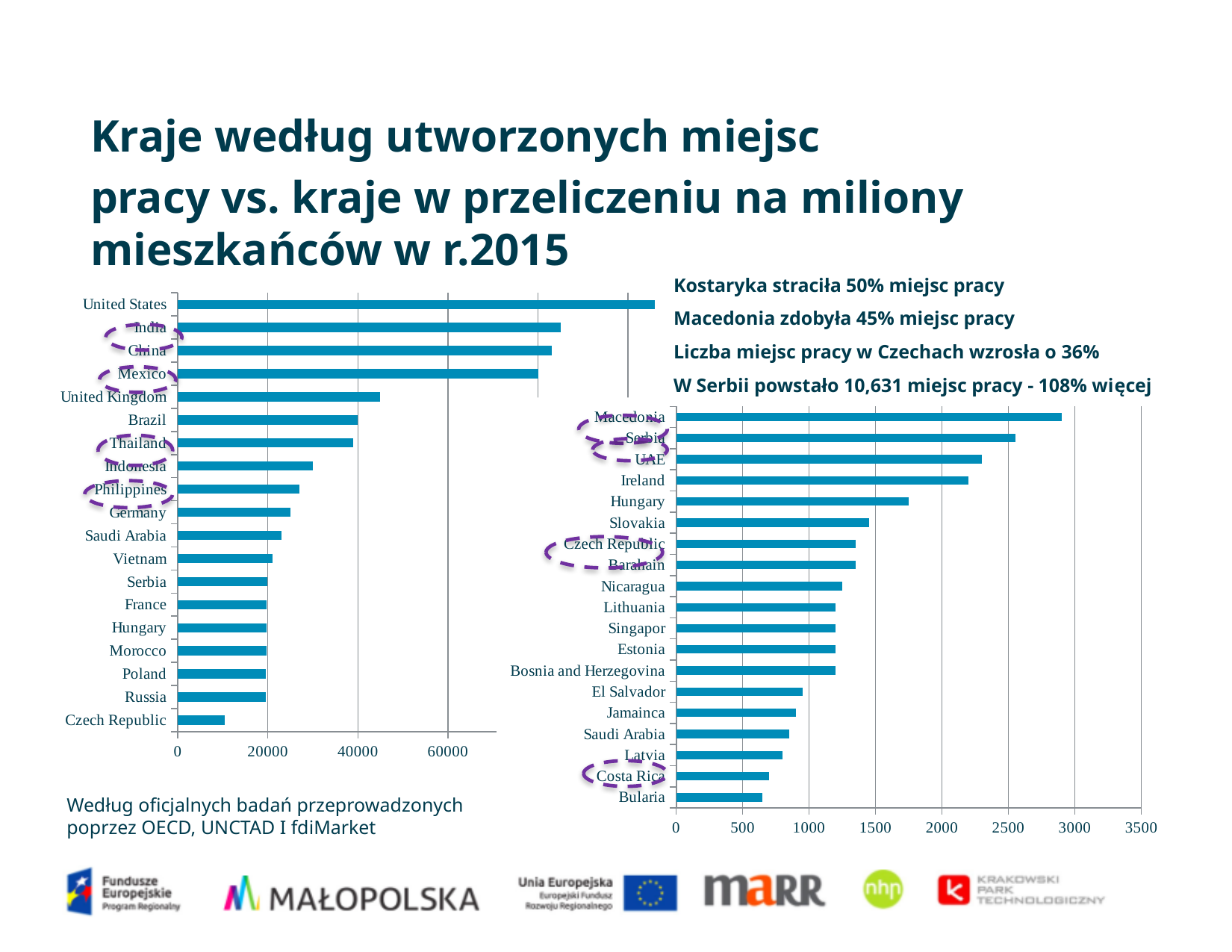
In the left chart (countries by jobs created), which country has the highest value? United States In the right chart (jobs per million inhabitants), is the value for Costa Rica greater or less than 1000? less In the left chart (countries by jobs created), is the value for Czech Republic greater or less than 20000? less In the right chart (jobs per million inhabitants), which country has the highest value? Macedonia In the left chart (countries by jobs created), is the value for United Kingdom greater or less than 40000? greater In the left chart (countries by jobs created), which country has the lowest value? Czech Republic What kind of chart is the left chart (countries by jobs created)? bar chart How many countries are listed in the left chart (countries by jobs created)? 19 In the right chart (jobs per million inhabitants), which is larger, the value for Macedonia or the value for Serbia? Macedonia In the right chart (jobs per million inhabitants), which country has the lowest value? Bularia